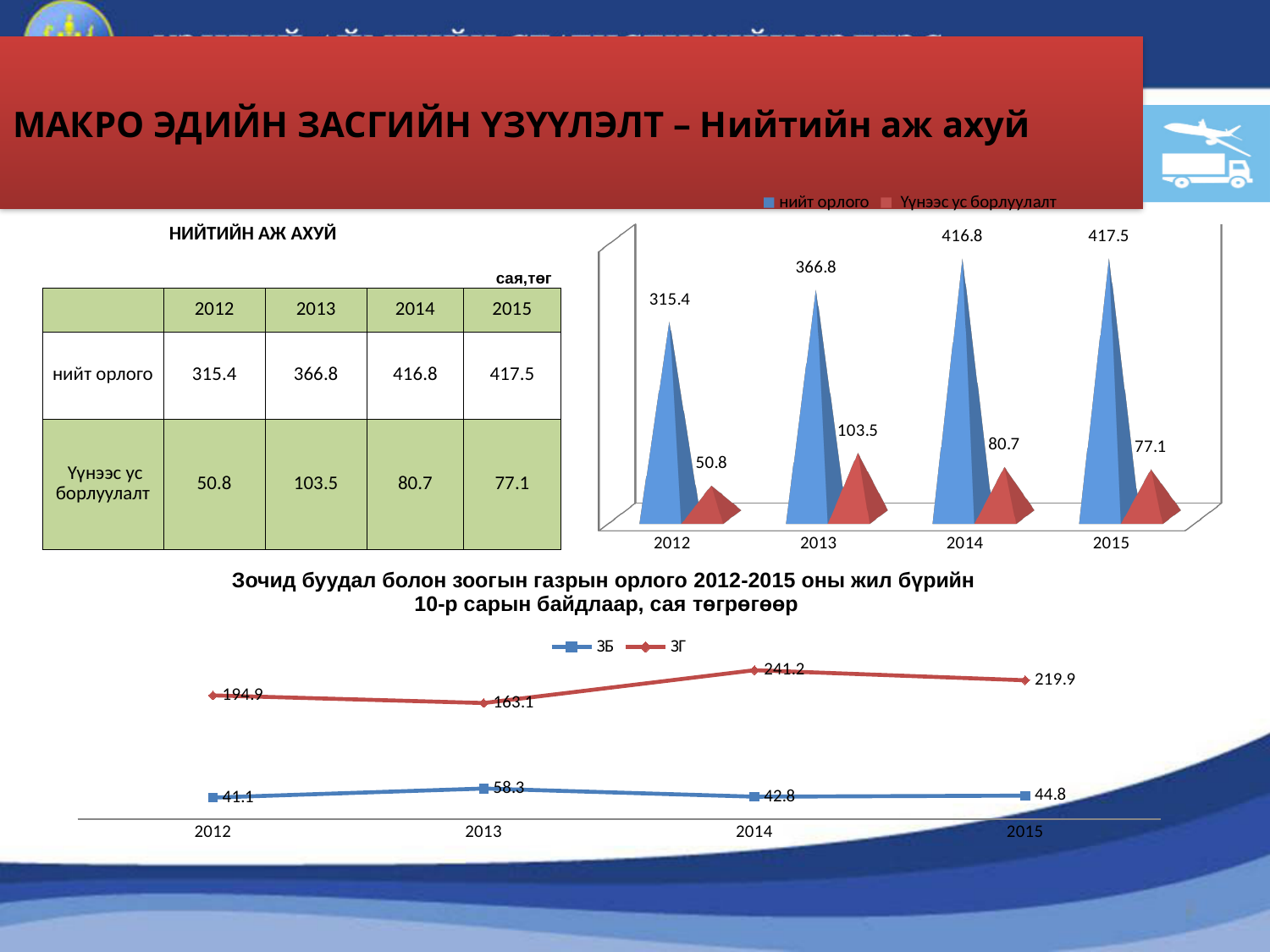
What kind of chart is the bottom chart on the slide? Line chart In the bottom line chart, what is the value of ЗБ for 2013? 58.3 In the top-right bar chart, what is the value of Үүнээс ус борлуулалт for 2013? 103.5 In the bottom line chart, what is the value of ЗГ for 2014? 241.2 How many years are shown on the x axis of the bottom line chart? 4 In the bottom line chart, which year has the lowest value for ЗГ? 2013 How many series does the legend of the top-right bar chart list? 2 In the top-right bar chart, what is the value of нийт орлого for 2014? 416.8 In the top-right bar chart, what is the difference between нийт орлого in 2013 and in 2012? 51.4 In the top-right bar chart, which year has the lowest value for нийт орлого? 2012 In the top-right bar chart, which year has the highest value for Үүнээс ус борлуулалт? 2013 In the bottom line chart, which is larger: ЗБ in 2015 or ЗБ in 2012? ЗБ in 2015